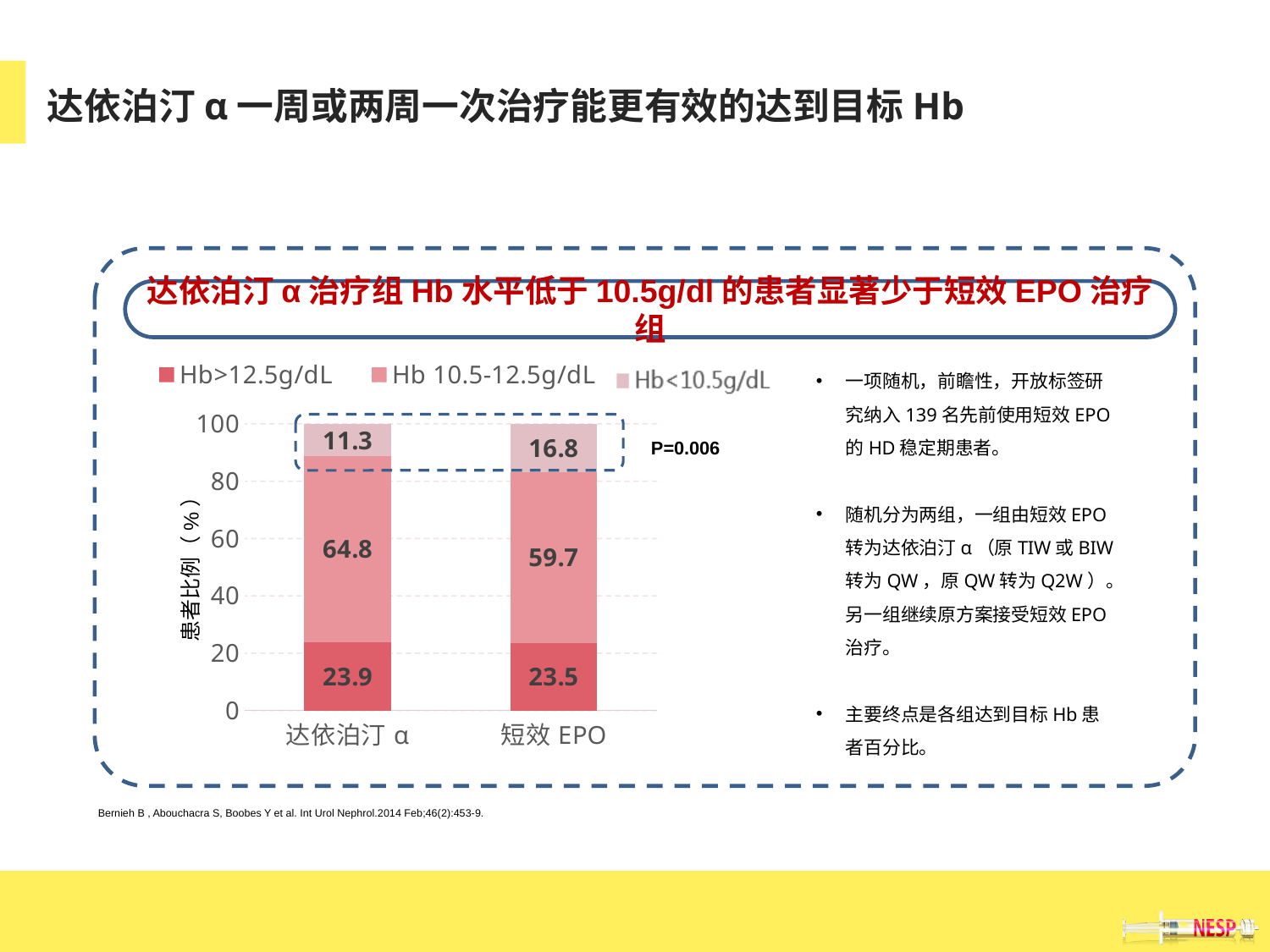
What is the difference between the Hb<10.5g/dL values for 短效 EPO and 达依泊汀 α? 5.5 What is the value of the Hb<10.5g/dL segment for 达依泊汀 α? 11.3 How many series does the legend list? 3 What is the value of the Hb>12.5g/dL segment for 短效 EPO? 23.5 Which group has the larger Hb<10.5g/dL segment, 达依泊汀 α or 短效 EPO? 短效 EPO What is the value of the Hb<10.5g/dL segment for 短效 EPO? 16.8 What is the total of the stacked bar for 达依泊汀 α? 100 What is the value of the Hb 10.5-12.5g/dL segment for 达依泊汀 α? 64.8 What is the difference between the Hb 10.5-12.5g/dL values for 达依泊汀 α and 短效 EPO? 5.1 What P value is printed next to the chart? P=0.006 How many categories are shown on the x axis? 2 What kind of chart is shown on the slide? Stacked bar chart